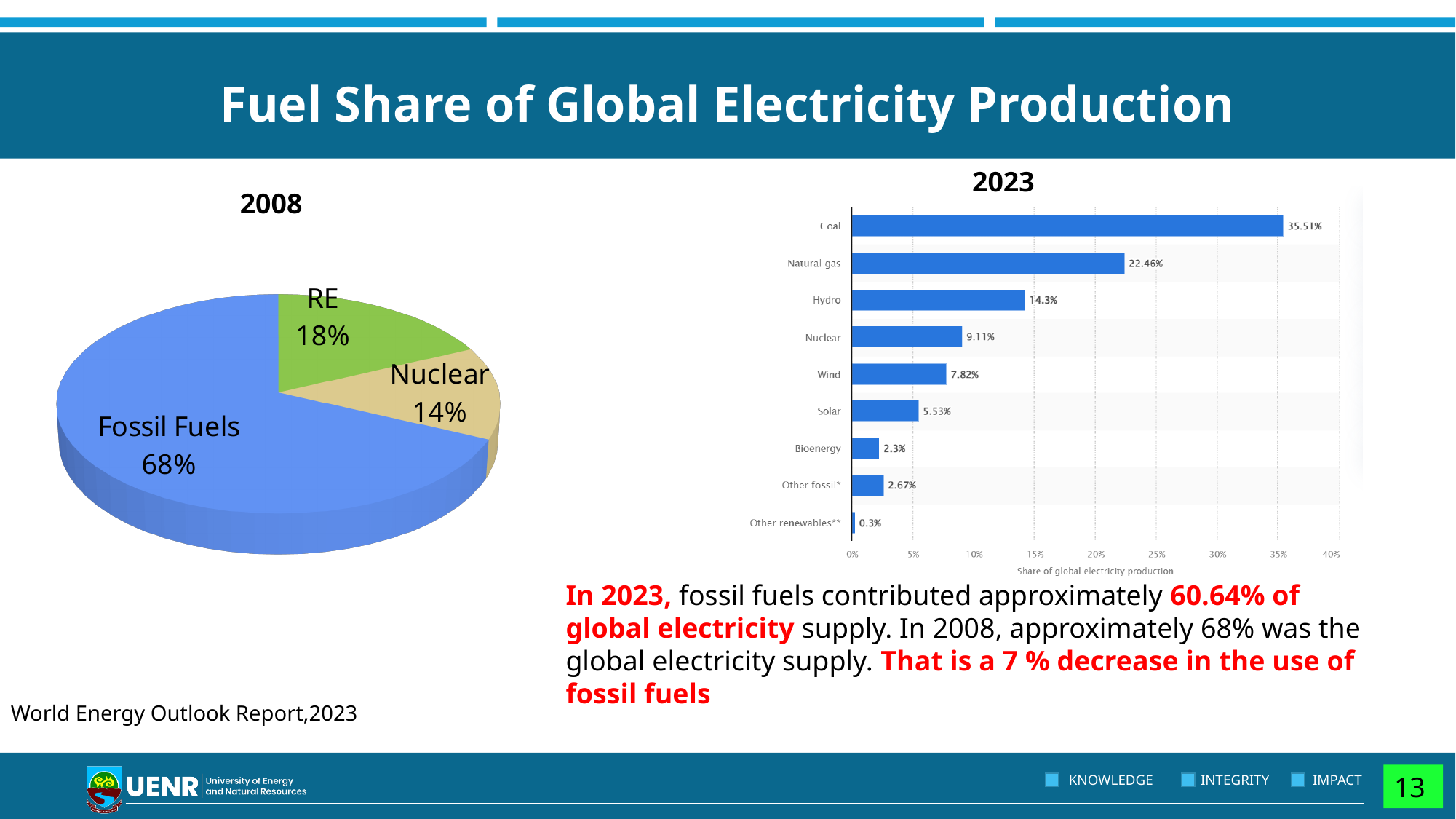
In the 2023 chart, what is the value for Wind? 7.82% In the 2008 pie chart, which category has the smallest share? Nuclear In the 2023 chart, which category has the lowest value? Other renewables** In the 2008 pie chart, what share does Nuclear have? 14% In the 2008 pie chart, what is the difference between the Fossil Fuels share and the RE share? 50% In the 2023 chart, what is the difference between Coal and Natural gas? 13.05% In the 2023 chart, which is larger, Hydro or Nuclear? Hydro In the 2008 pie chart, what share do Fossil Fuels have? 68% In the 2008 pie chart, how many slices are there? 3 What kind of chart is the 2023 chart? Bar chart In the 2023 chart, what is the value for Coal? 35.51% In the 2023 chart, how many categories are shown? 9